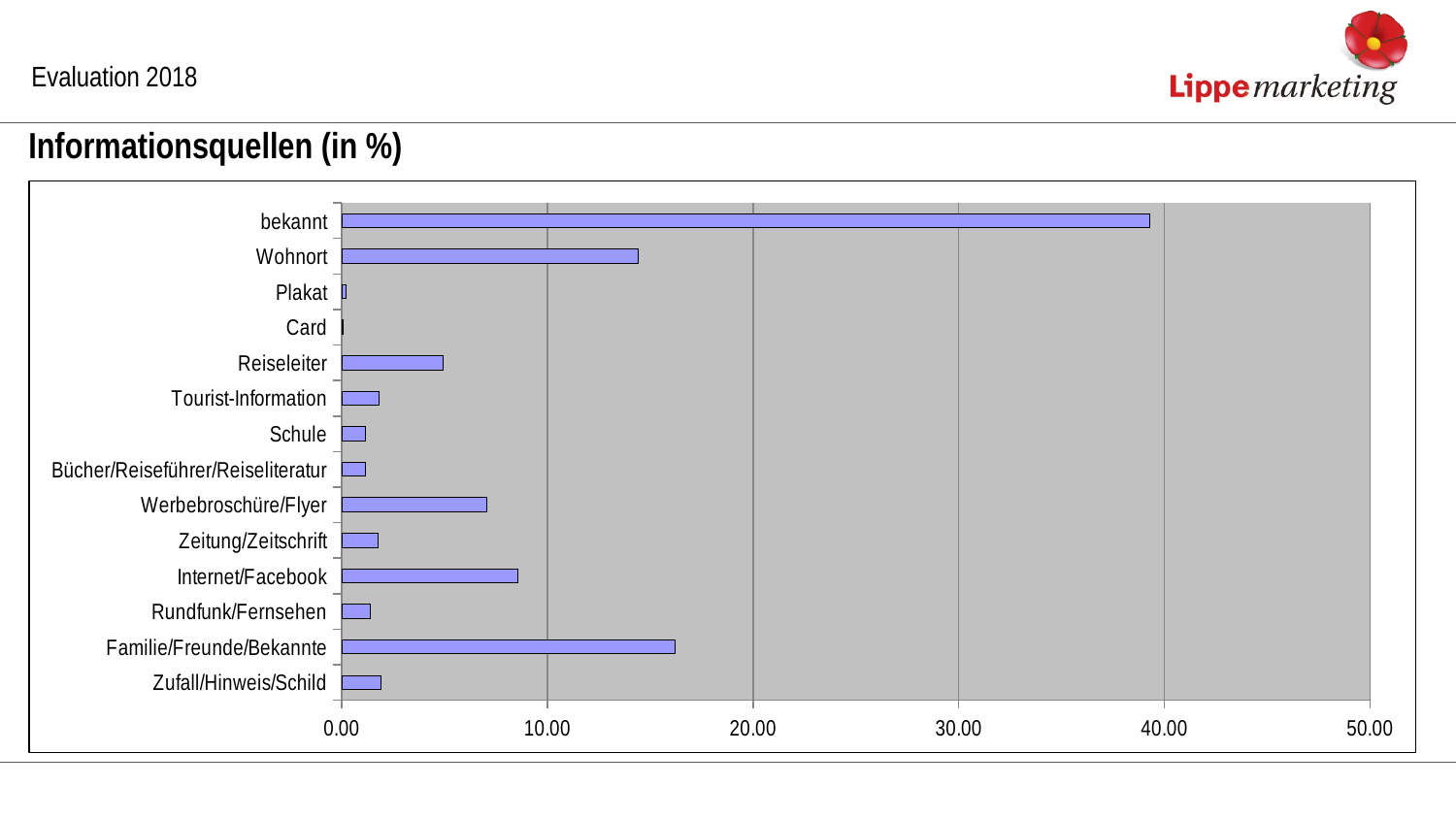
How many categories are shown in the chart? 14 Is the value for Internet/Facebook greater or less than 10? less What kind of chart is shown on the slide? bar chart Is the value for bekannt greater or less than 30? greater Which is larger, the value for Internet/Facebook or the value for Werbebroschüre/Flyer? Internet/Facebook Is the value for Wohnort greater or less than 10? greater Which is larger, the value for Familie/Freunde/Bekannte or the value for Wohnort? Familie/Freunde/Bekannte Which is larger, the value for Reiseleiter or the value for Schule? Reiseleiter What is the title of the chart? Informationsquellen (in %) Which category has the highest value in the chart? bekannt